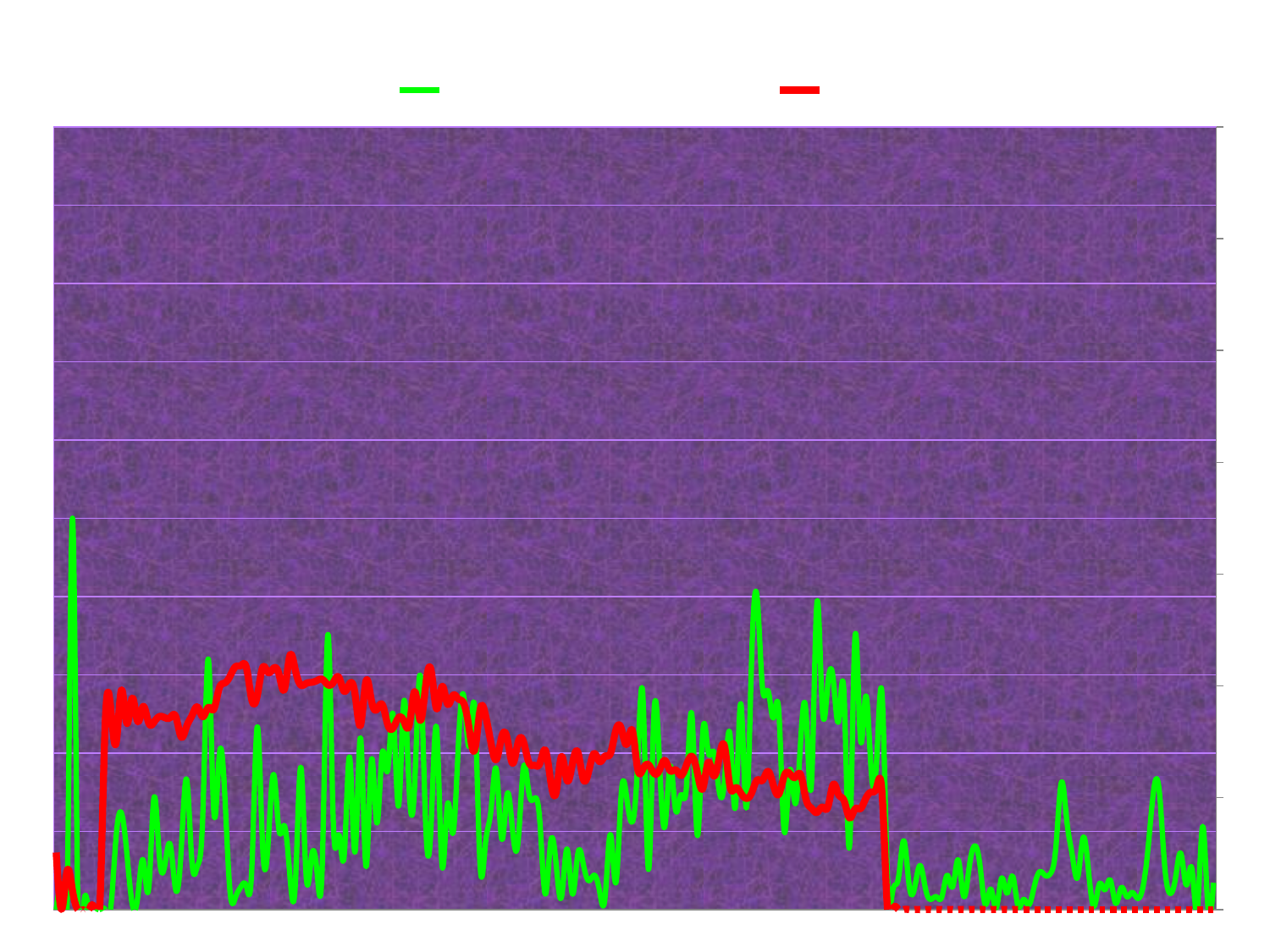
Which series reaches the highest peak on the chart, the green one or the red one? the green series How many series does the legend list? 2 Which series stays flat along the bottom of the chart in the right-hand portion? the red series What kind of chart is shown on the slide? line chart What colours are the two lines plotted on the chart? green and red